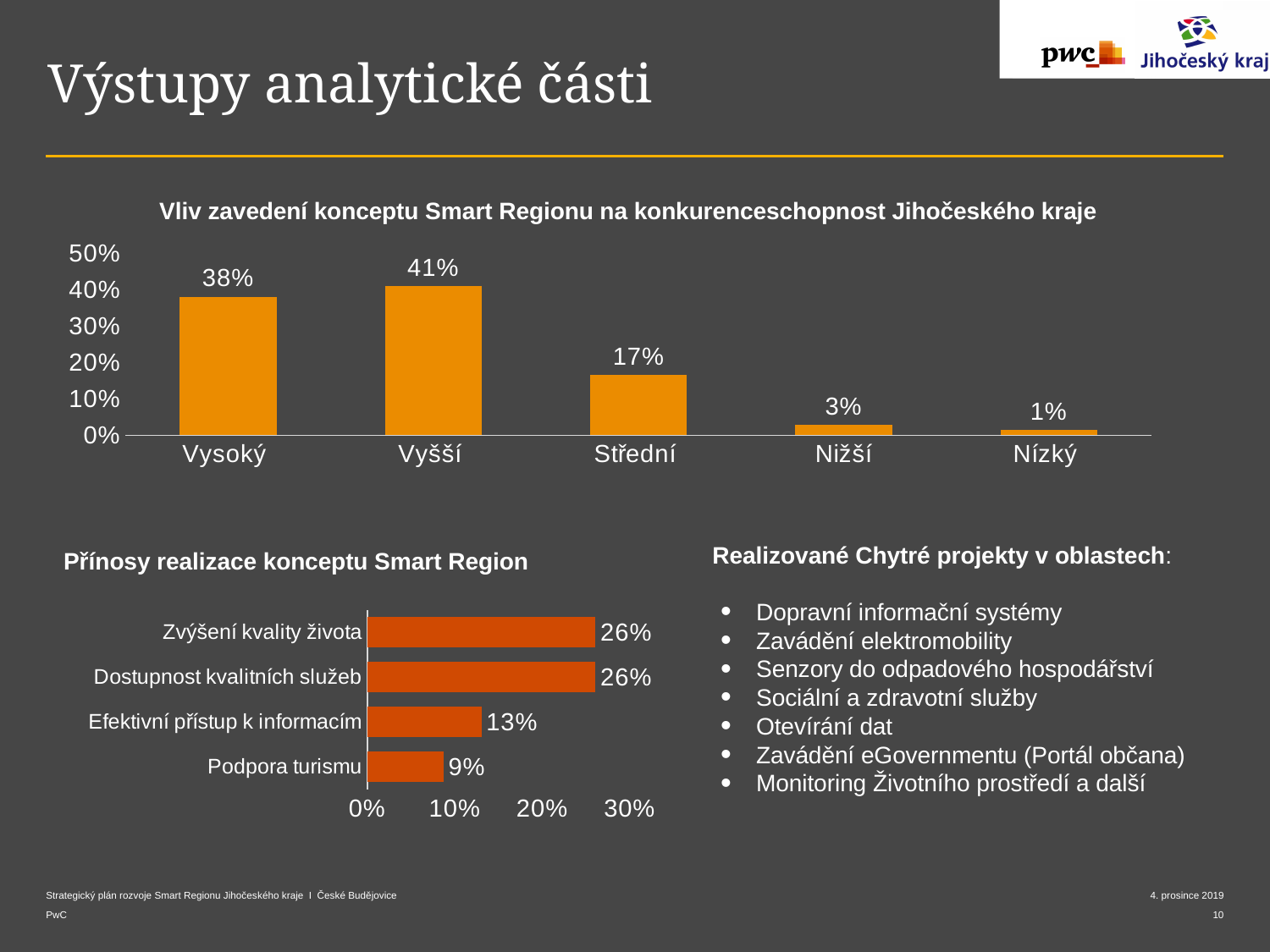
In the chart 'Vliv zavedení konceptu Smart Regionu na konkurenceschopnost Jihočeského kraje', do the values rise or fall from left to right after Vyšší? fall In the chart 'Vliv zavedení konceptu Smart Regionu na konkurenceschopnost Jihočeského kraje', which category has the highest value? Vyšší In the chart 'Přínosy realizace konceptu Smart Region', what is the value for Efektivní přístup k informacím? 13% In the chart 'Vliv zavedení konceptu Smart Regionu na konkurenceschopnost Jihočeského kraje', which category has the lowest value? Nízký In the chart 'Vliv zavedení konceptu Smart Regionu na konkurenceschopnost Jihočeského kraje', how many categories are shown? 5 In the chart 'Přínosy realizace konceptu Smart Region', which category has the lowest value? Podpora turismu In the chart 'Vliv zavedení konceptu Smart Regionu na konkurenceschopnost Jihočeského kraje', what is the value for Vyšší? 41% In the chart 'Vliv zavedení konceptu Smart Regionu na konkurenceschopnost Jihočeského kraje', what is the difference between Vysoký and Střední? 21% In the chart 'Přínosy realizace konceptu Smart Region', what is the difference between Zvýšení kvality života and Podpora turismu? 17% In the chart 'Vliv zavedení konceptu Smart Regionu na konkurenceschopnost Jihočeského kraje', what is the value for Nižší? 3% What type of chart is 'Přínosy realizace konceptu Smart Region'? bar chart In the chart 'Přínosy realizace konceptu Smart Region', which is larger: Efektivní přístup k informacím or Podpora turismu? Efektivní přístup k informacím